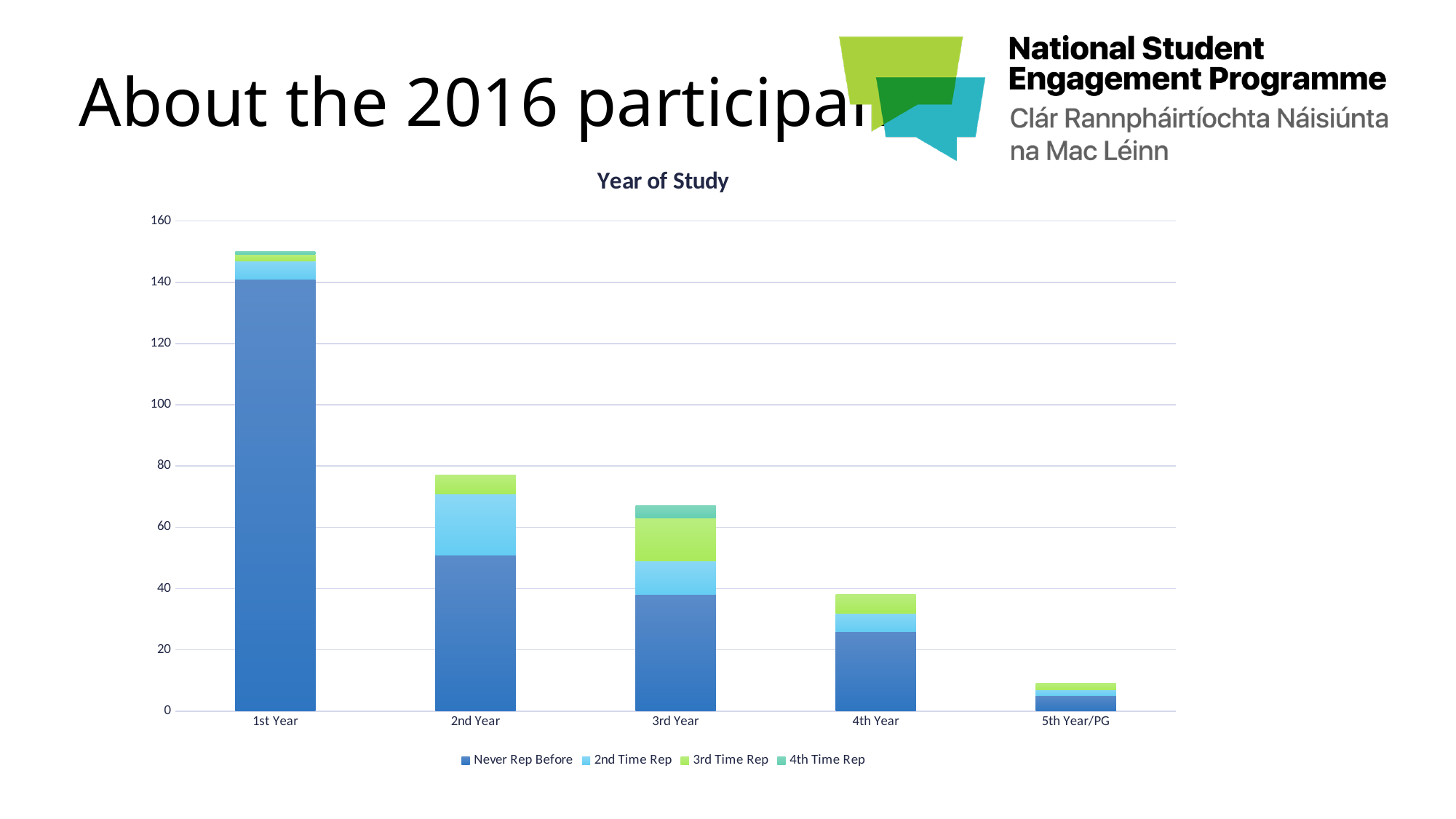
Do the total bar heights rise or fall moving from 1st Year to 5th Year/PG? Fall Is the Never Rep Before value for 2nd Year greater or less than 40? greater Which year of study has the shortest stacked bar? 5th Year/PG What is the title of the chart? Year of Study Which has the larger total stacked bar, 2nd Year or 3rd Year? 2nd Year Which legend entry is shown in the darkest blue colour? Never Rep Before How many series does the legend list? 4 Is the total stacked bar for 5th Year/PG greater or less than 20? less How many year-of-study categories are shown on the x axis? 5 Which year of study has the tallest stacked bar? 1st Year What kind of chart is shown on the slide? Stacked bar chart Is the total stacked bar for 1st Year greater or less than 140? greater